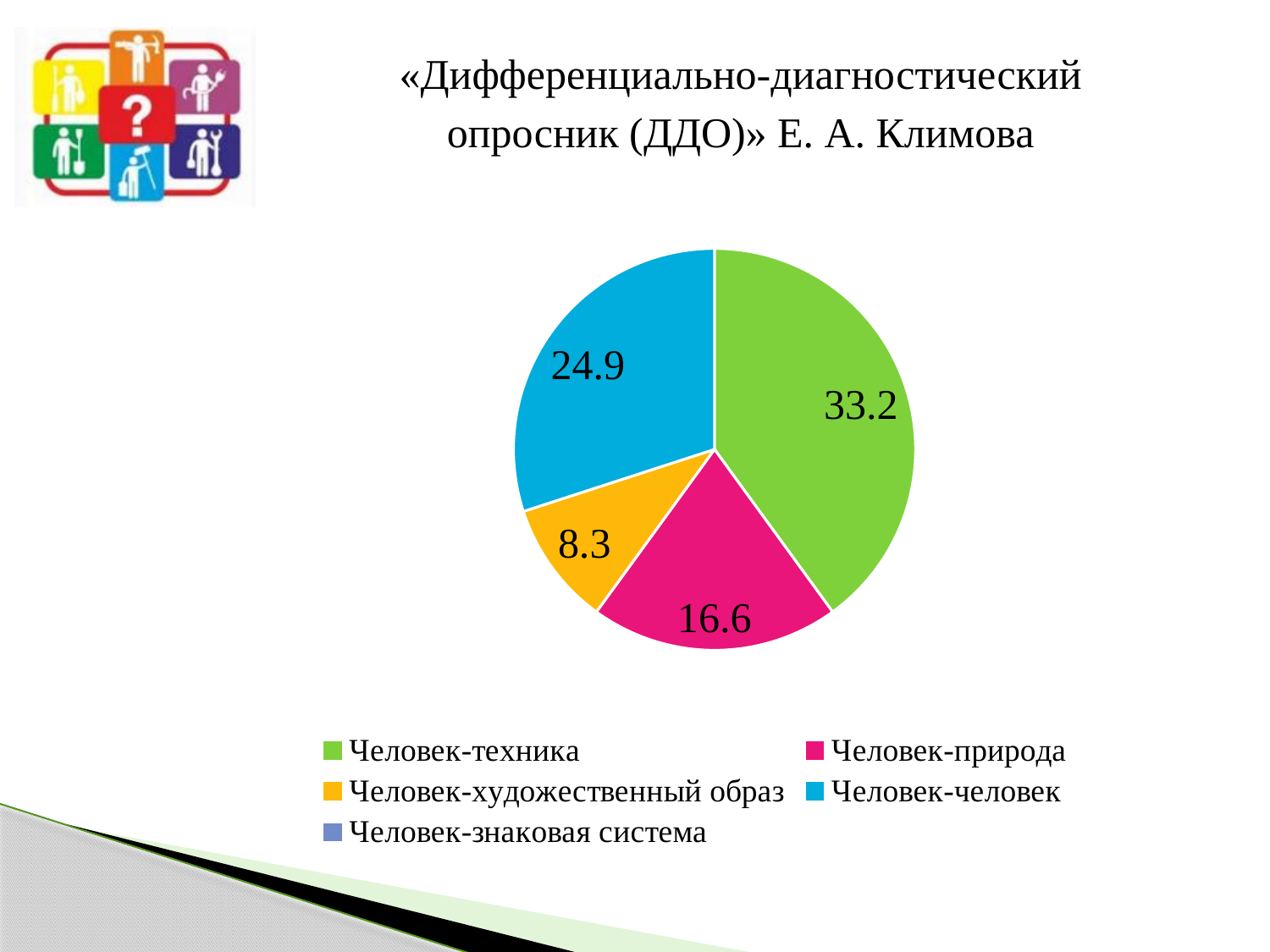
Which category has the largest slice in the pie chart? Человек-техника What value is shown for the Человек-природа slice of the pie chart? 16.6 What value is shown for the Человек-художественный образ slice of the pie chart? 8.3 What is the difference between the values for Человек-природа and Человек-художественный образ? 8.3 What colour is the Человек-человек slice in the pie chart? Blue Which is larger: the value for Человек-человек or the value for Человек-природа? Человек-человек What is the difference between the values for Человек-техника and Человек-человек? 8.3 What value is shown for the Человек-человек slice of the pie chart? 24.9 What value is shown for the Человек-техника slice of the pie chart? 33.2 Which labelled category has the smallest slice in the pie chart? Человек-художественный образ How many entries does the legend of the pie chart list? 5 What kind of chart is shown on the slide? Pie chart